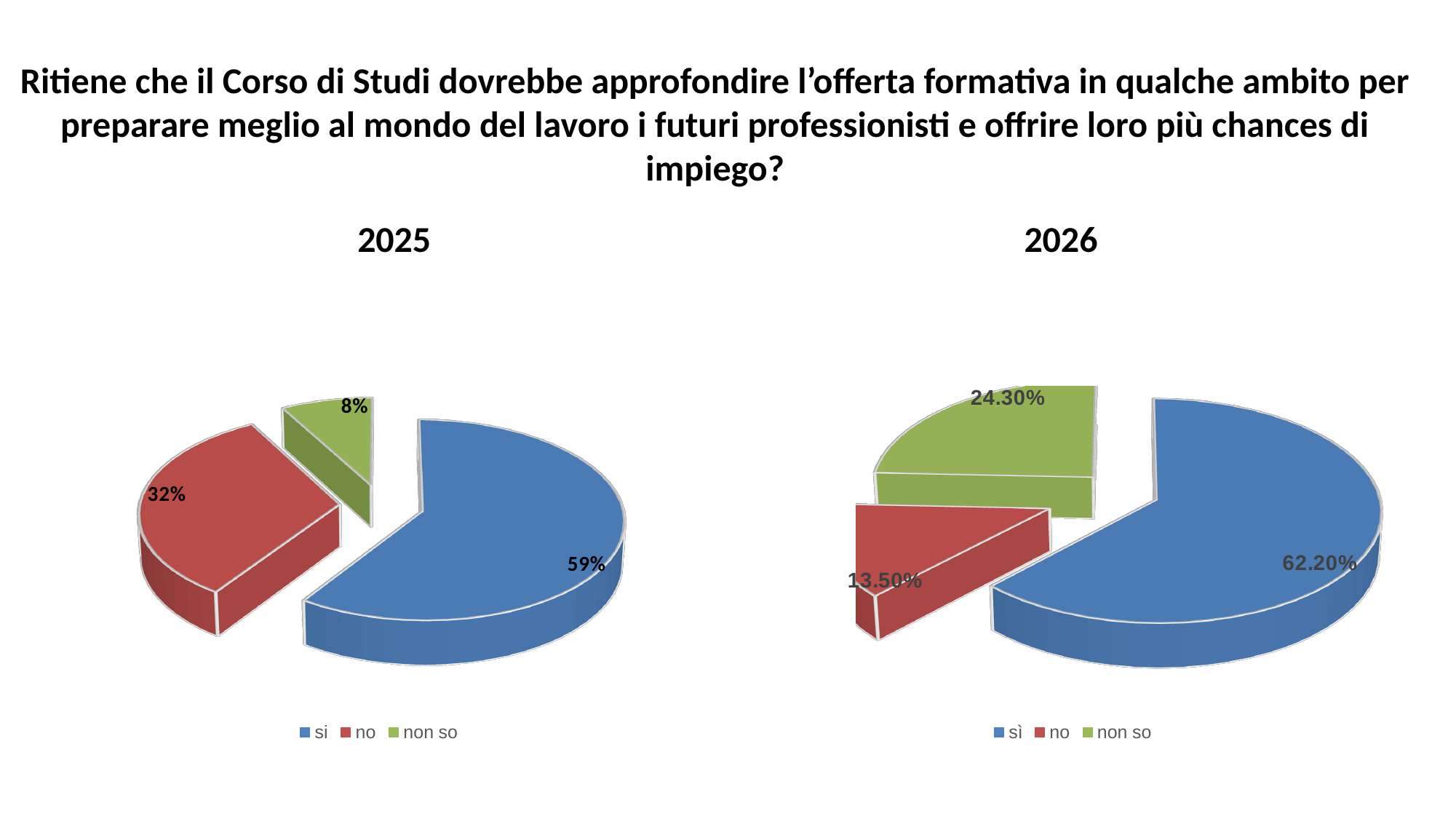
In the 2025 chart, what percentage of respondents answered "non so"? 8% In the 2026 chart, what percentage of respondents answered "sì"? 62.20% In the 2026 chart, what percentage of respondents answered "no"? 13.50% In the 2025 chart, what percentage of respondents answered "si"? 59% In the 2025 chart, what is the difference in percentage points between "si" and "no"? 27 What kind of chart is the 2026 chart? Pie chart In the 2026 chart, what percentage of respondents answered "non so"? 24.30% In the 2025 chart, what percentage of respondents answered "no"? 32% How many categories does the legend of the 2025 chart list? 3 In the 2026 chart, which is larger: the share for "no" or the share for "non so"? non so In the 2026 chart, which response has the smallest share? no In the 2025 chart, which response has the largest share? si